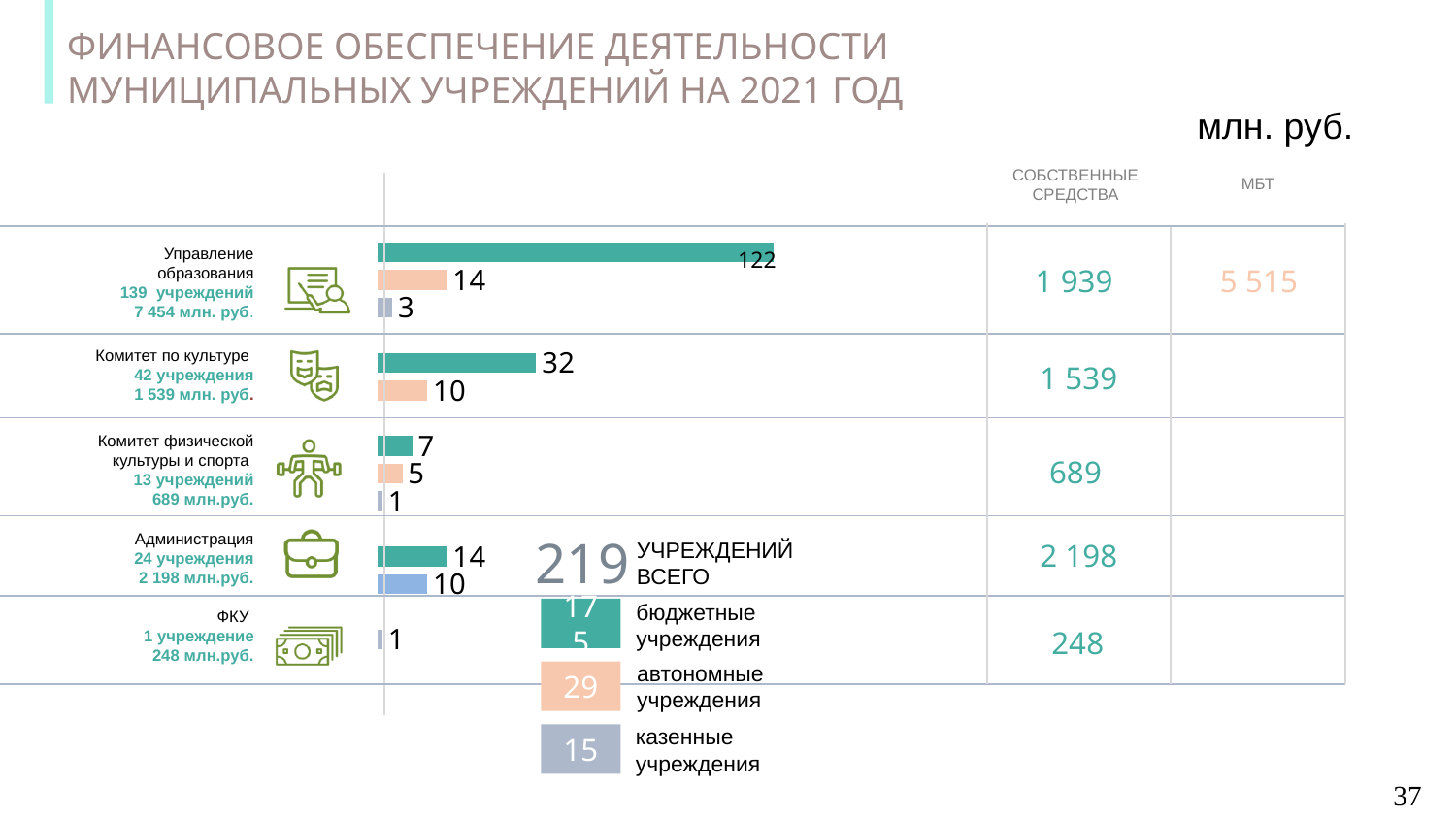
How many budget institutions (бюджетные учреждения) does Управление образования have according to the bar chart? 122 How many autonomous institutions (автономные учреждения) does Комитет по культуре have according to the bar chart? 10 What is the difference between the number of budget institutions of Управление образования and Комитет по культуре? 90 What is the total number of institutions (учреждений всего) shown next to the bar chart? 219 How many series (types of institutions) does the legend of the bar chart list? 3 What value of собственные средства is shown for Комитет по культуре? 1 539 How many departments (categories) are shown in the bar chart? 5 Which is larger: the number of budget institutions of Администрация or of Комитет физической культуры и спорта? Администрация What kind of chart is used on the slide to show the number of institutions by department? bar chart Which department has the highest number of budget institutions (бюджетные учреждения) in the bar chart? Управление образования How many state-owned institutions (казенные учреждения) does Администрация have according to the bar chart? 10